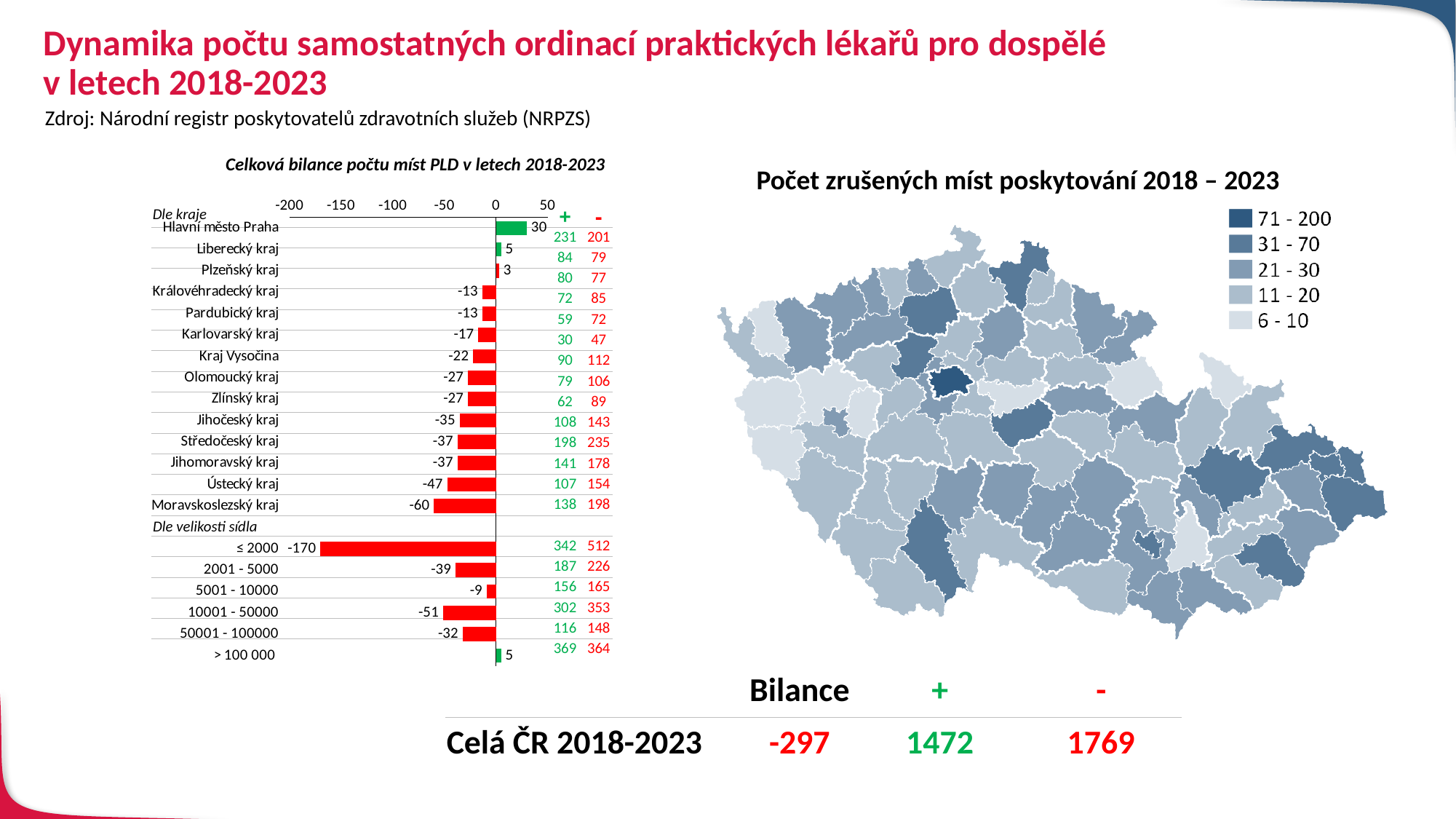
In the chart 'Celková bilance počtu míst PLD v letech 2018-2023', which region (kraj) has the highest value? Hlavní město Praha In the chart 'Celková bilance počtu míst PLD v letech 2018-2023', is the value for the category ≤ 2000 greater or less than -150? less In the chart 'Celková bilance počtu míst PLD v letech 2018-2023', what is the difference between the values for Hlavní město Praha and Moravskoslezský kraj? 90 In the chart 'Celková bilance počtu míst PLD v letech 2018-2023', what is the value for Moravskoslezský kraj? -60 What is the title of the map on the right side of the slide? Počet zrušených míst poskytování 2018 – 2023 In the chart 'Celková bilance počtu míst PLD v letech 2018-2023', which region (kraj) has the lowest value? Moravskoslezský kraj What kind of chart is 'Celková bilance počtu míst PLD v letech 2018-2023'? Bar chart In the chart 'Celková bilance počtu míst PLD v letech 2018-2023', what is the value for the settlement size category ≤ 2000? -170 In the chart 'Celková bilance počtu míst PLD v letech 2018-2023', how many regions (kraje) are listed under 'Dle kraje'? 14 In the chart 'Celková bilance počtu míst PLD v letech 2018-2023', which settlement size category has the lowest value? ≤ 2000 In the chart 'Celková bilance počtu míst PLD v letech 2018-2023', what is the value for Hlavní město Praha? 30 In the chart 'Celková bilance počtu míst PLD v letech 2018-2023', which has the larger value, Ústecký kraj or Jihočeský kraj? Jihočeský kraj